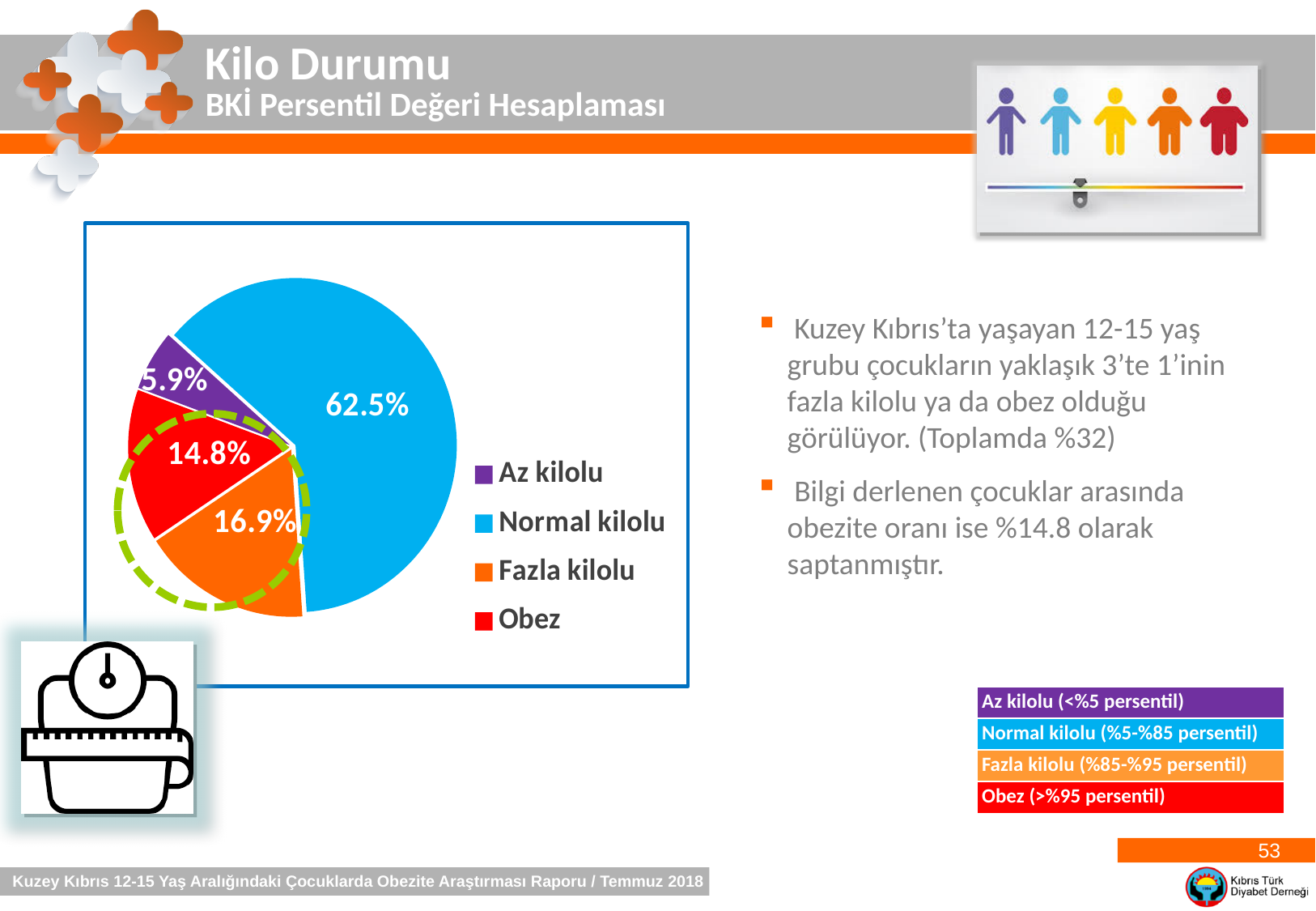
What percentage of the pie chart is labelled Fazla kilolu? 16.9% What percentage of the pie chart is labelled Obez? 14.8% How many entries does the chart legend list? 4 What percentage of the pie chart is labelled Normal kilolu? 62.5% How many slices does the pie chart have? 4 What colour is the Normal kilolu slice in the pie chart? Blue Which slice is larger, Fazla kilolu or Obez? Fazla kilolu What type of chart is shown on the slide? Pie chart Which category has the smallest slice in the pie chart? Az kilolu What percentage of the pie chart is labelled Az kilolu? 5.9% What is the difference in percentage points between the Fazla kilolu and Obez slices? 2.1 Which category has the largest slice in the pie chart? Normal kilolu